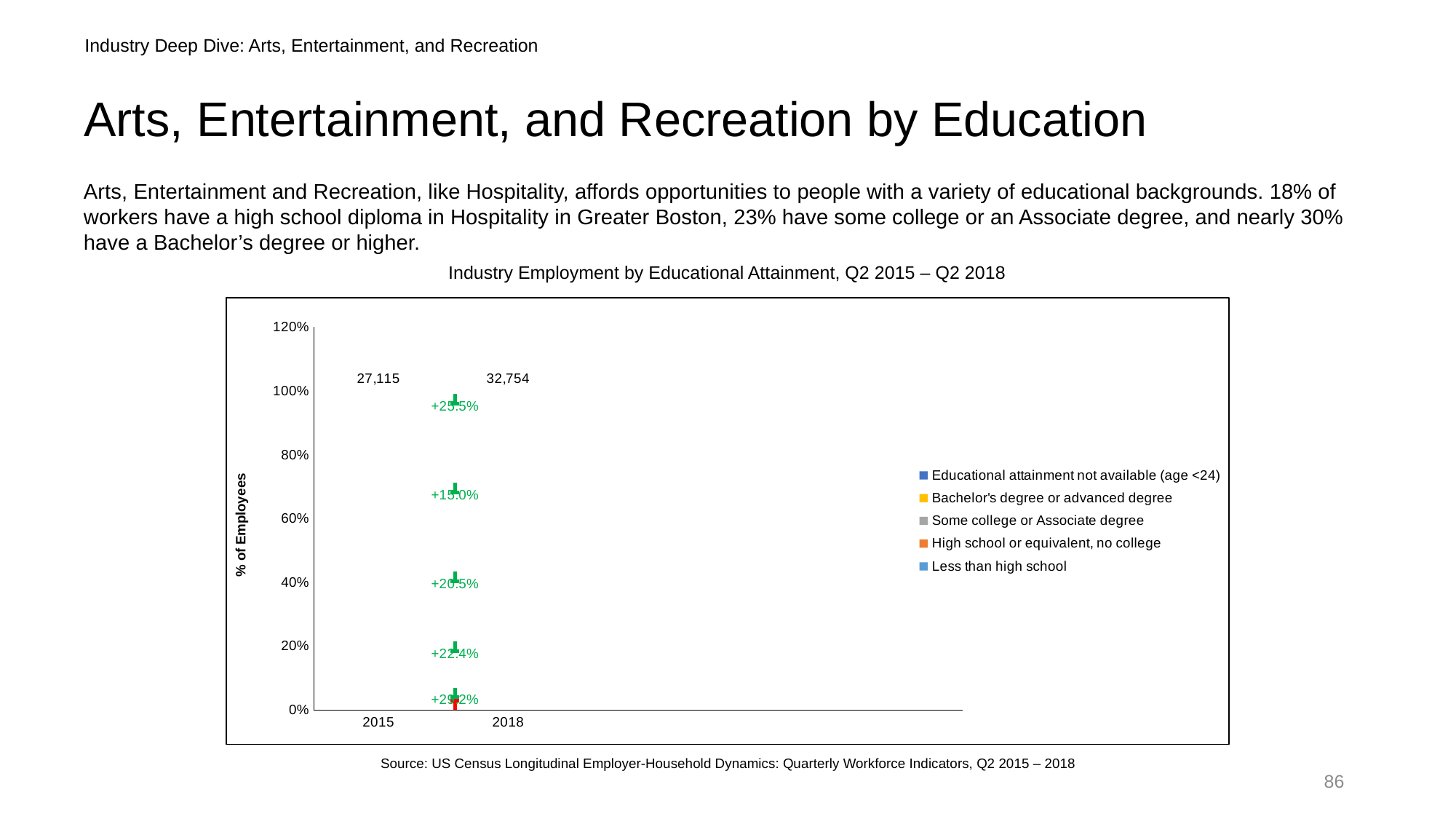
What total employment figure is printed above the 2018 bar? 32,754 What is the title of the chart? Industry Employment by Educational Attainment, Q2 2015 – Q2 2018 Which year has the larger total employment figure, 2015 or 2018? 2018 What is the highest value shown on the y axis of the chart? 120% How many years are shown on the x axis of the chart? 2 How many series does the chart's legend list? 5 What percentage change is printed in green at the top of the chart, between the 2015 and 2018 bars? +25.5% What is the label on the y axis of the chart? % of Employees What total employment figure is printed above the 2015 bar? 27,115 What is the difference between the 2018 total (32,754) and the 2015 total (27,115)? 5,639